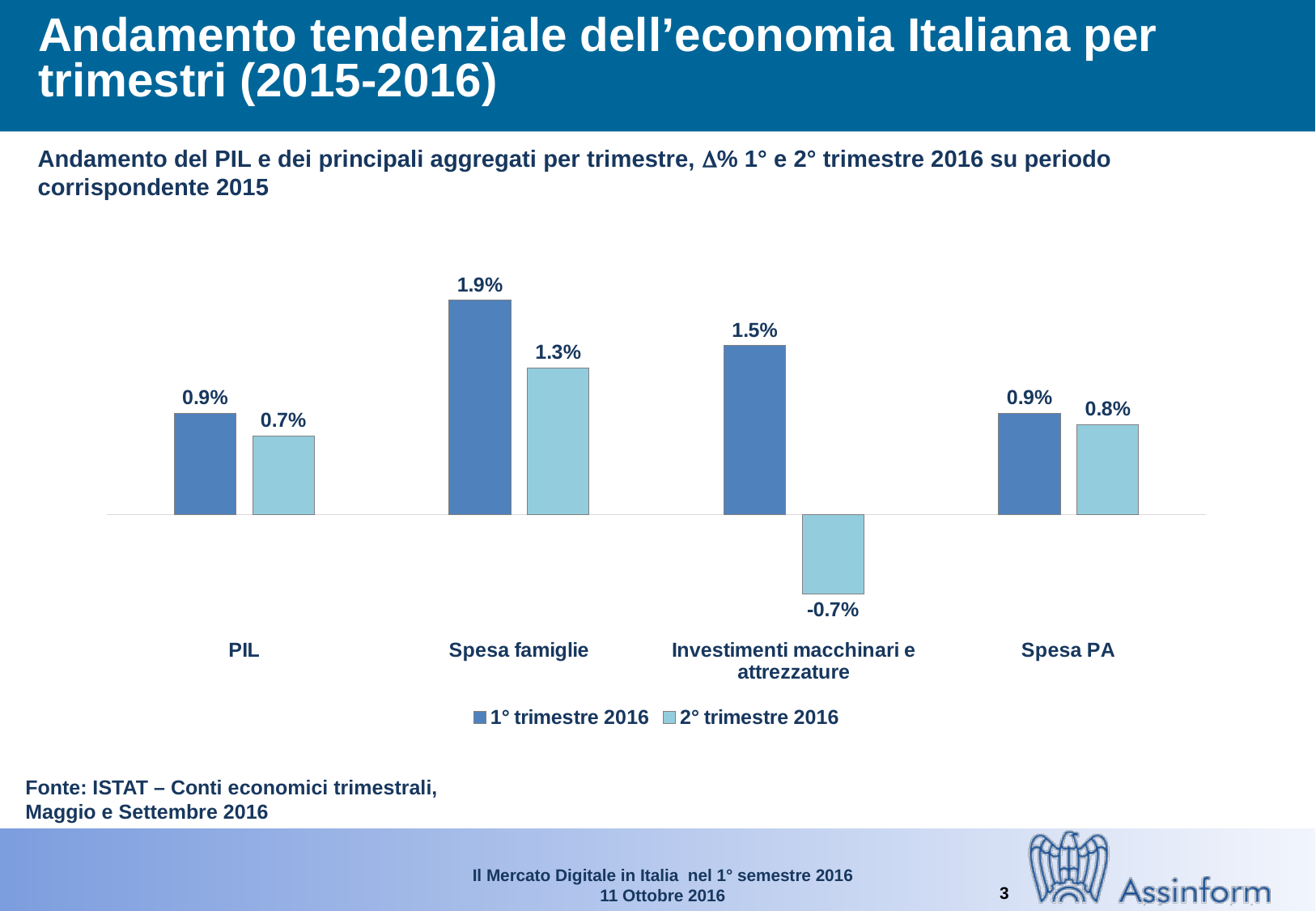
What is the value for Spesa famiglie in 2° trimestre 2016? 1.3% What is the value for Spesa PA in 2° trimestre 2016? 0.8% How many categories are shown on the x axis? 4 Which is larger for Investimenti macchinari e attrezzature: the 1° trimestre 2016 value or the 2° trimestre 2016 value? 1° trimestre 2016 Which category has the lowest value in 2° trimestre 2016? Investimenti macchinari e attrezzature What is the value for Investimenti macchinari e attrezzature in 2° trimestre 2016? -0.7% What kind of chart is shown on the slide? Bar chart What are the two series named in the legend? 1° trimestre 2016 and 2° trimestre 2016 What is the difference between the 1° trimestre 2016 and 2° trimestre 2016 values for Spesa famiglie? 0.6% Which category has the highest value in 1° trimestre 2016? Spesa famiglie What is the value for PIL in 1° trimestre 2016? 0.9% How many series does the legend list? 2